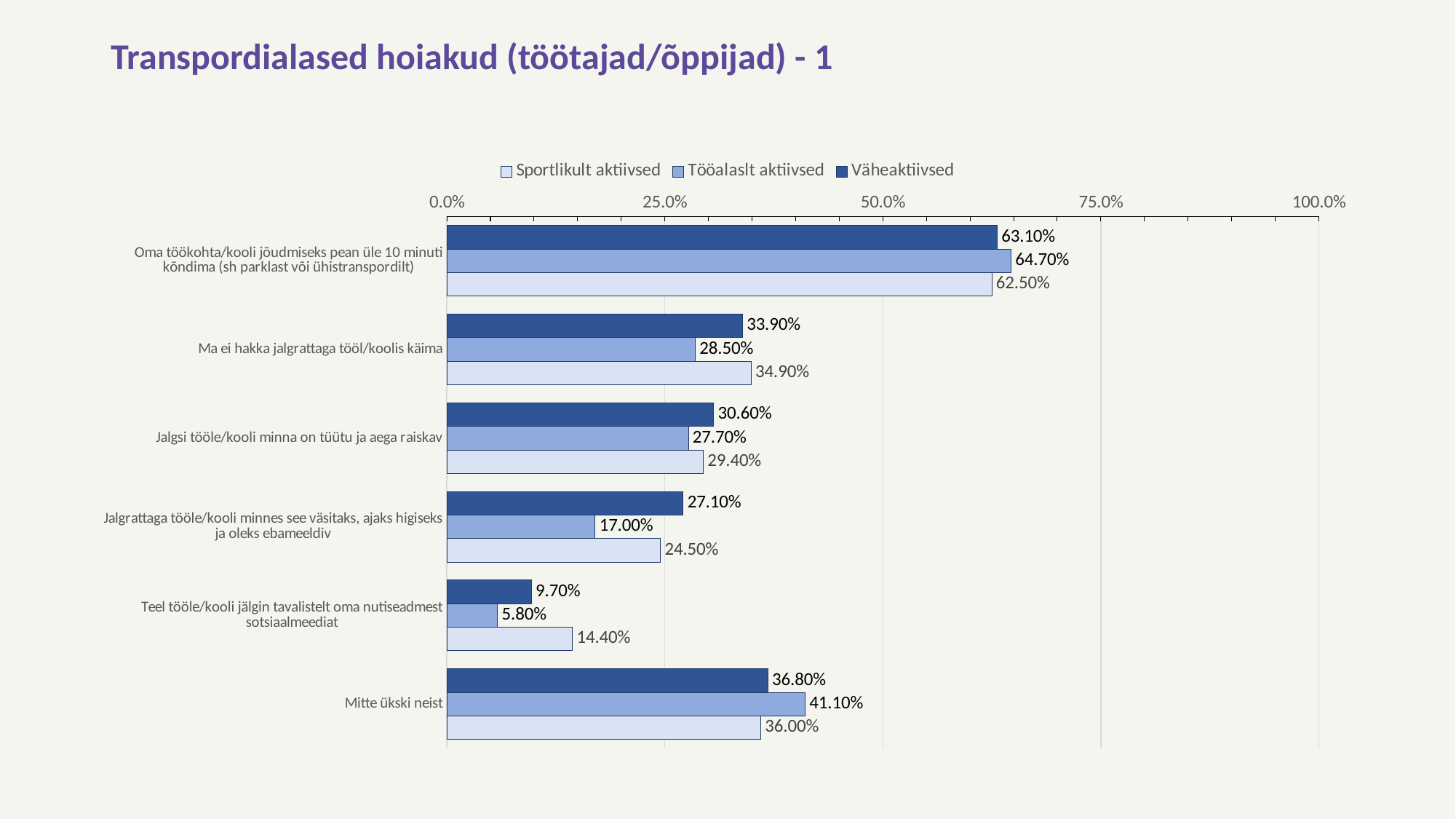
What is the difference between the Väheaktiivsed and Tööalaslt aktiivsed values for "Jalgrattaga tööle/kooli minnes see väsitaks, ajaks higiseks ja oleks ebameeldiv"? 10.10% How many series does the legend list? 3 How many categories are shown on the chart? 6 For "Ma ei hakka jalgrattaga tööl/koolis käima", which is larger: the Sportlikult aktiivsed value or the Tööalaslt aktiivsed value? Sportlikult aktiivsed What kind of chart is shown on the slide? Bar chart What is the value for Tööalaslt aktiivsed for "Mitte ükski neist"? 41.10% Which category has the lowest value for Tööalaslt aktiivsed? Teel tööle/kooli jälgin tavalistelt oma nutiseadmest sotsiaalmeediat What is the title of the slide? Transpordialased hoiakud (töötajad/õppijad) - 1 Is the Tööalaslt aktiivsed value for "Oma töökohta/kooli jõudmiseks pean üle 10 minuti kõndima" greater or less than 50.0%? greater What is the value for Sportlikult aktiivsed for "Teel tööle/kooli jälgin tavalistelt oma nutiseadmest sotsiaalmeediat"? 14.40% What is the value for Väheaktiivsed for "Jalgrattaga tööle/kooli minnes see väsitaks, ajaks higiseks ja oleks ebameeldiv"? 27.10% Which category has the highest value for Väheaktiivsed? Oma töökohta/kooli jõudmiseks pean üle 10 minuti kõndima (sh parklast või ühistranspordilt)